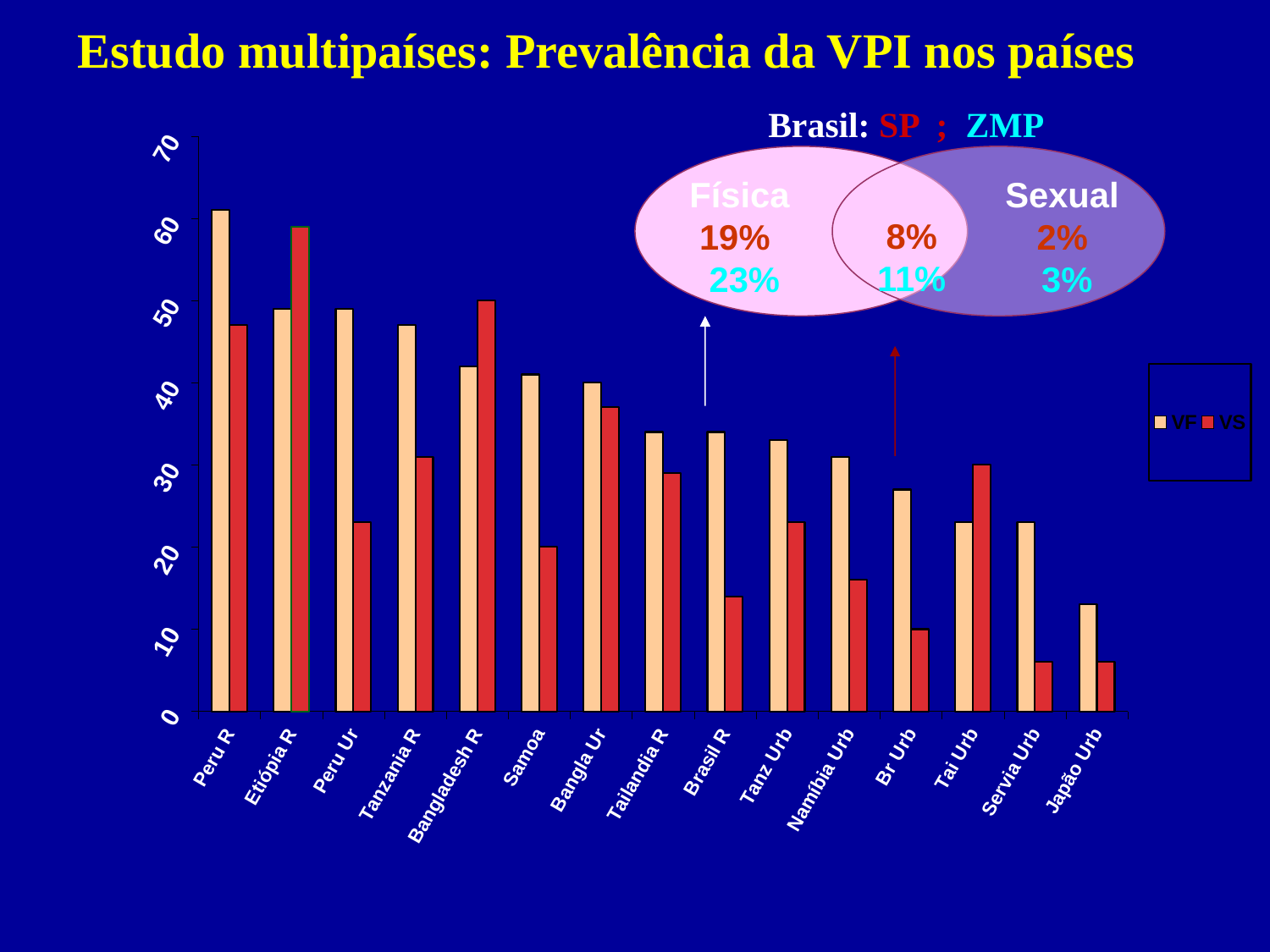
Is the VF value for Peru R greater or less than 50? greater For Bangladesh R, which is larger, the VF value or the VS value? VS How many countries/sites are shown along the x axis? 15 How many series does the legend list? 2 Is the VS value for Bangladesh R greater or less than 40? greater Which category has the highest VS value? Etiópia R Is the VS value for Brasil R greater or less than 20? less What are the two series named in the legend? VF and VS Which category has the highest VF value? Peru R Which category has the lowest VF value? Japão Urb Do the VF values generally rise or fall from left to right along the x axis? fall What kind of chart is shown on the slide? bar chart